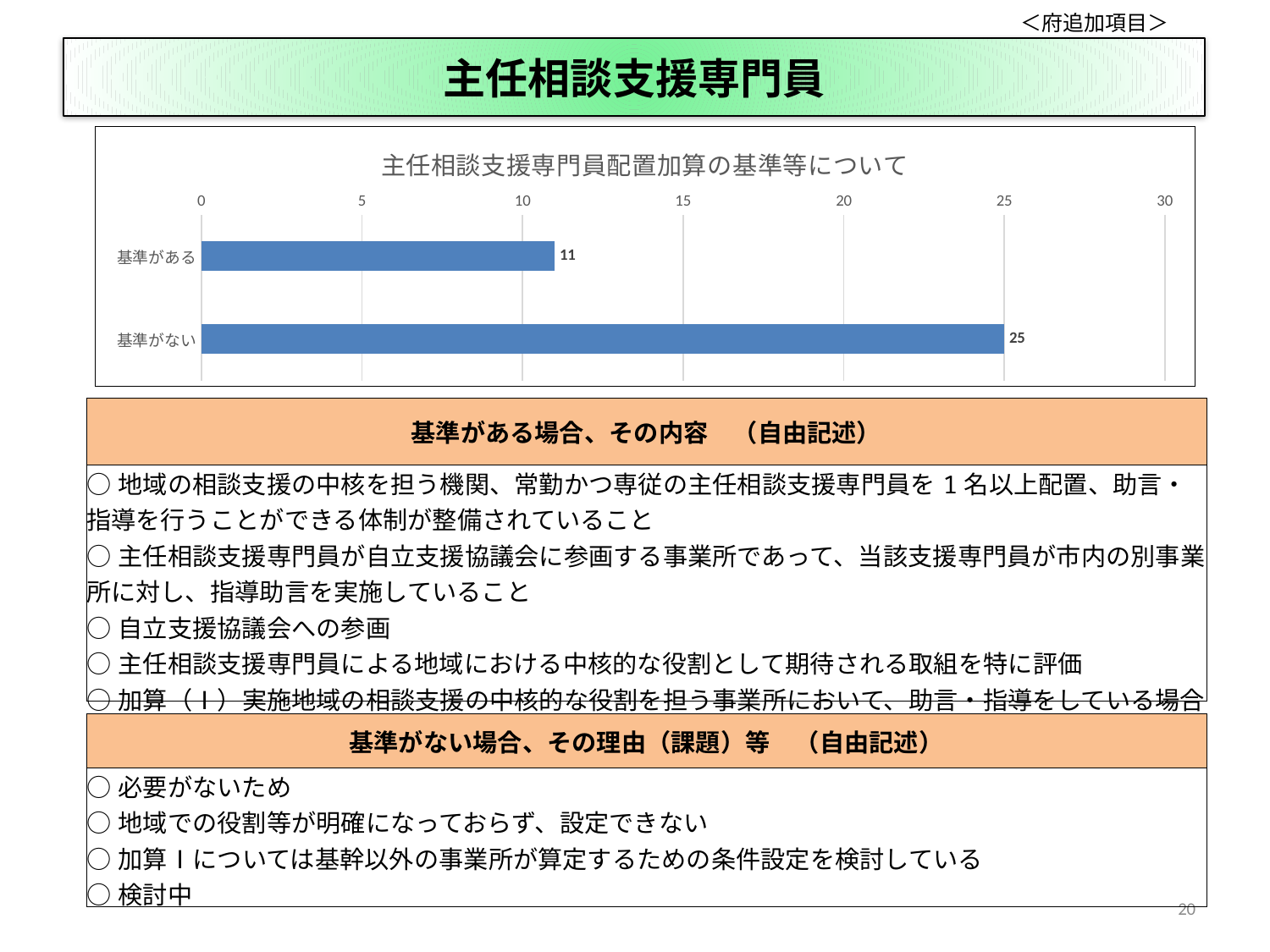
What is the difference between the values for 基準がない and 基準がある? 14 What is the title of the chart? 主任相談支援専門員配置加算の基準等について Is the value for 基準がある greater or less than 10? greater What kind of chart is shown on the slide? bar chart Is the value for 基準がない greater or less than 30? less What is the value for 基準がある? 11 What is the value for 基準がない? 25 How many categories are shown in the chart? 2 Which category has the lowest value? 基準がある What is the maximum value shown on the chart's axis? 30 Which is larger, the value for 基準がある or the value for 基準がない? 基準がない Which category has the highest value? 基準がない